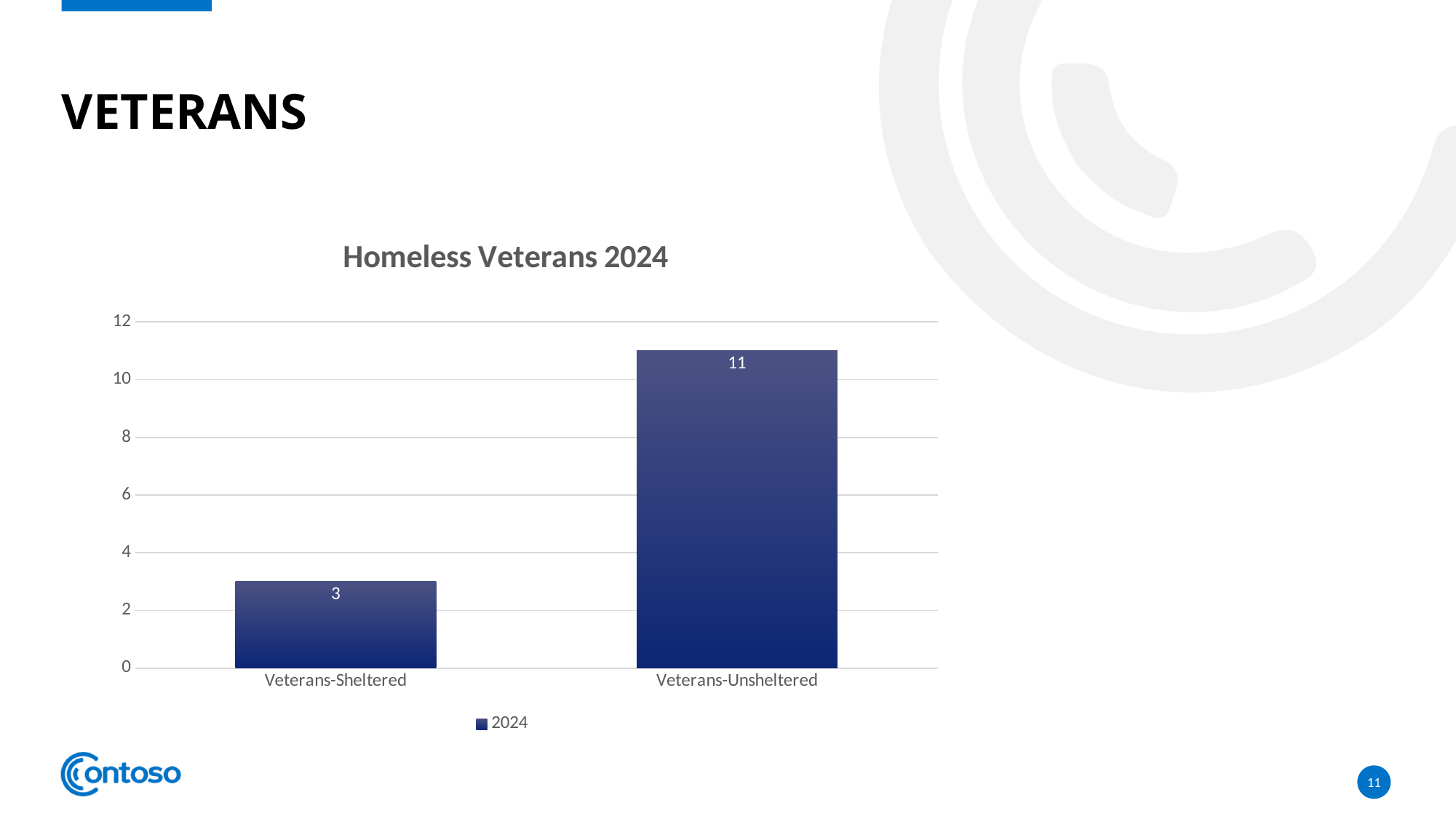
Which is larger, the value for Veterans-Sheltered or Veterans-Unsheltered? Veterans-Unsheltered Is the value for Veterans-Sheltered greater or less than 4? less What is the value for Veterans-Sheltered? 3 Which category has the lowest value? Veterans-Sheltered What kind of chart is shown on the slide? bar chart How many categories are shown on the x axis? 2 What is the title of the chart? Homeless Veterans 2024 Is the value for Veterans-Unsheltered greater or less than 10? greater How many series does the legend list? 1 What is the value for Veterans-Unsheltered? 11 Which category has the highest value? Veterans-Unsheltered What is the difference between the values for Veterans-Unsheltered and Veterans-Sheltered? 8